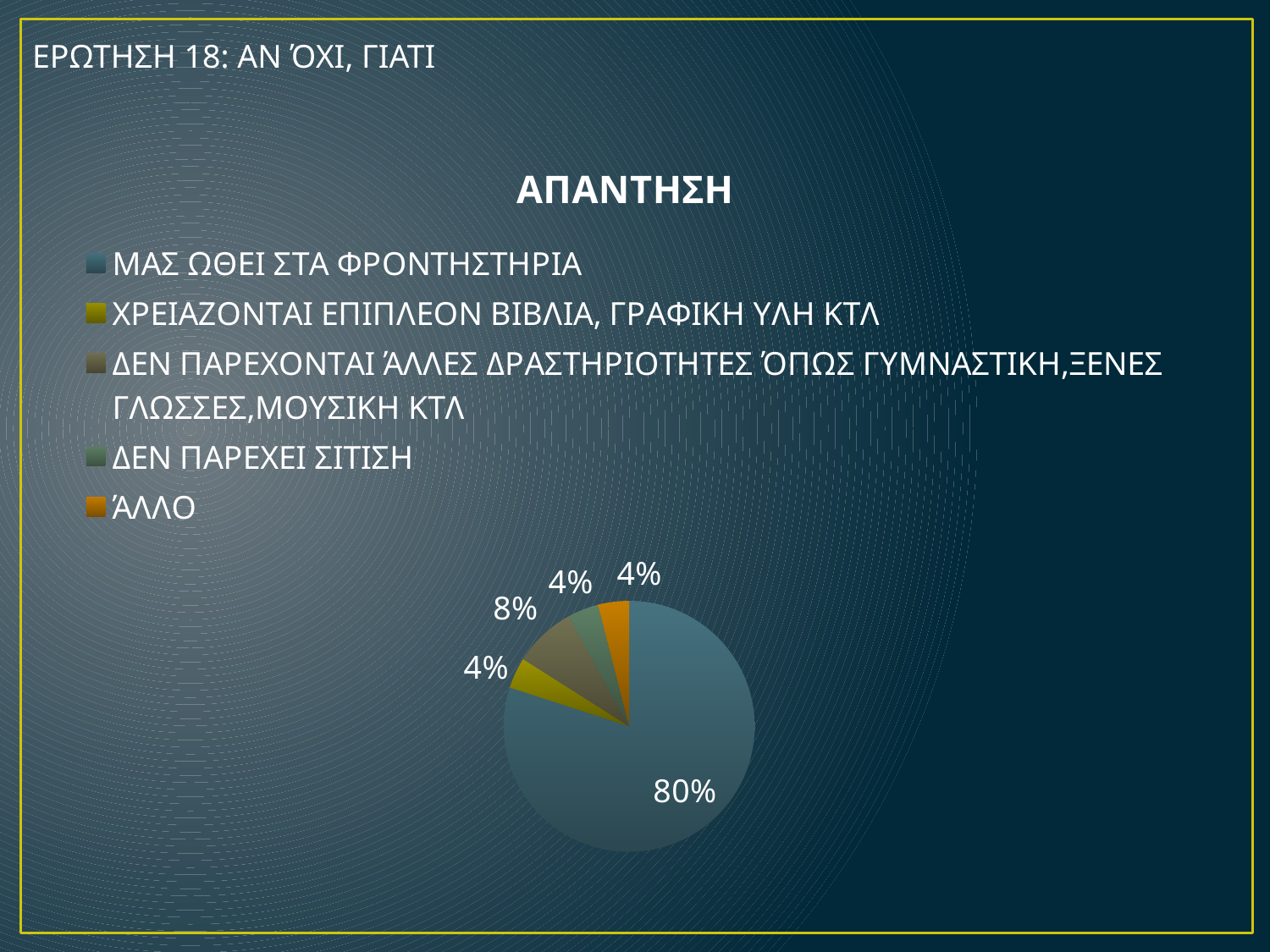
What percentage is shown for ΆΛΛΟ? 4% What percentage is shown for ΔΕΝ ΠΑΡΕΧΟΝΤΑΙ ΆΛΛΕΣ ΔΡΑΣΤΗΡΙΟΤΗΤΕΣ ΌΠΩΣ ΓΥΜΝΑΣΤΙΚΗ,ΞΕΝΕΣ ΓΛΩΣΣΕΣ,ΜΟΥΣΙΚΗ ΚΤΛ? 8% What is the title of the chart? ΑΠΑΝΤΗΣΗ What type of chart is shown on the slide? pie chart What percentage is shown for ΧΡΕΙΑΖΟΝΤΑΙ ΕΠΙΠΛΕΟΝ ΒΙΒΛΙΑ, ΓΡΑΦΙΚΗ ΥΛΗ ΚΤΛ? 4% What is the difference in percentage points between the ΜΑΣ ΩΘΕΙ ΣΤΑ ΦΡΟΝΤΗΣΤΗΡΙΑ slice and the ΔΕΝ ΠΑΡΕΧΟΝΤΑΙ ΆΛΛΕΣ ΔΡΑΣΤΗΡΙΟΤΗΤΕΣ slice? 72 How many categories does the legend of the pie chart list? 5 What percentage is shown for ΔΕΝ ΠΑΡΕΧΕΙ ΣΙΤΙΣΗ? 4% Which category has the largest slice of the pie? ΜΑΣ ΩΘΕΙ ΣΤΑ ΦΡΟΝΤΗΣΤΗΡΙΑ How many slices of the pie are labelled 4%? 3 Which slice is larger: ΔΕΝ ΠΑΡΕΧΟΝΤΑΙ ΆΛΛΕΣ ΔΡΑΣΤΗΡΙΟΤΗΤΕΣ or ΆΛΛΟ? ΔΕΝ ΠΑΡΕΧΟΝΤΑΙ ΆΛΛΕΣ ΔΡΑΣΤΗΡΙΟΤΗΤΕΣ What percentage of the pie is labelled for ΜΑΣ ΩΘΕΙ ΣΤΑ ΦΡΟΝΤΗΣΤΗΡΙΑ? 80%